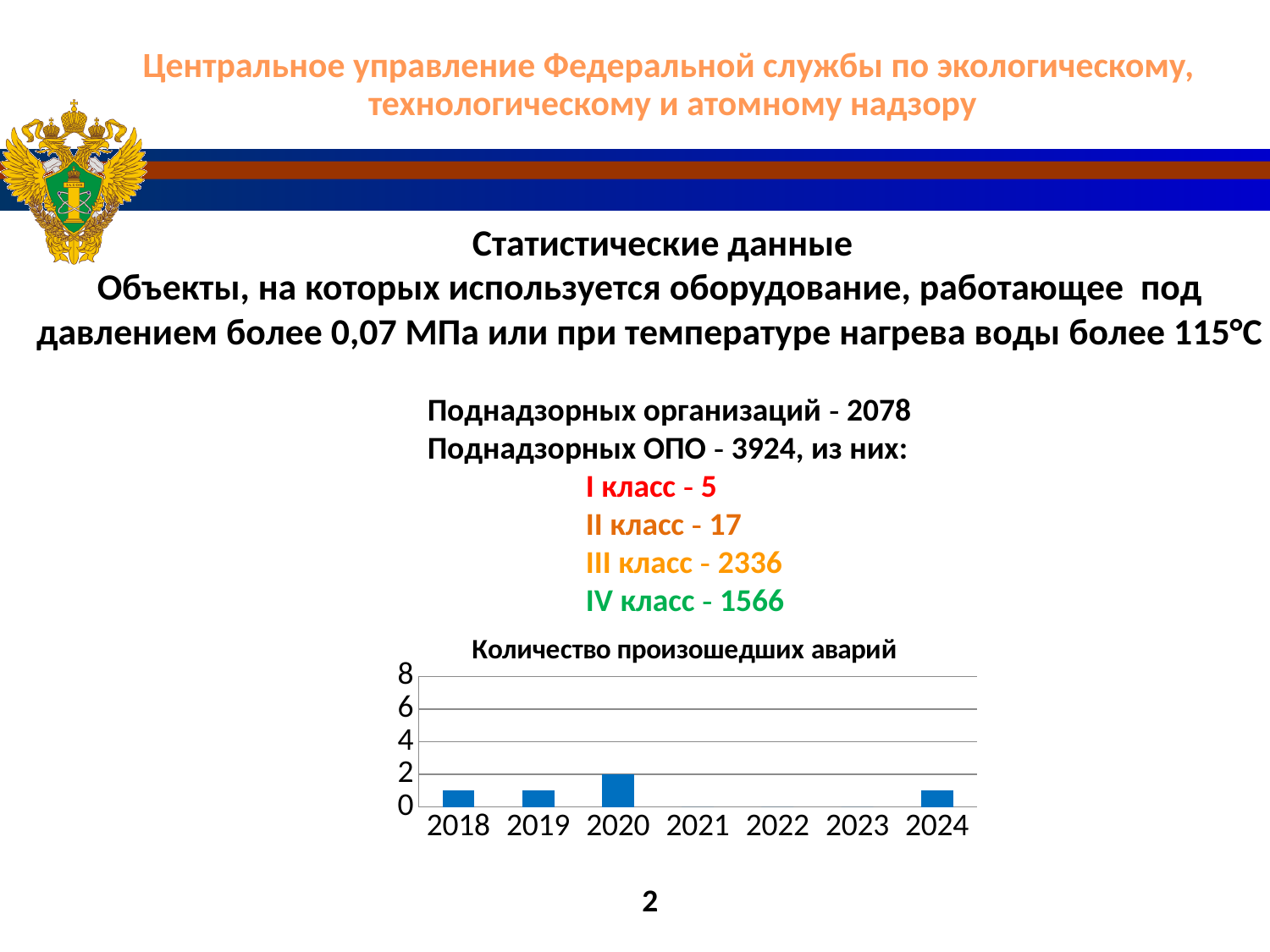
Which year has the highest number of accidents in the chart? 2020 Do the values in the chart rise steadily from 2018 to 2024? No How many years are shown on the x axis of the chart? 7 What is the highest value shown on the y axis of the chart? 8 What type of chart is shown on the slide? bar chart What is the title of the chart on the slide? Количество произошедших аварий Which is larger in the chart, the value for 2019 or the value for 2020? 2020 Is the value for 2020 greater or less than 4? less Which is larger in the chart, the value for 2021 or the value for 2024? 2024 Is the value for 2018 greater or less than 2? less What is the value for 2020 in the chart? 2 What is the value for 2022 in the chart? 0